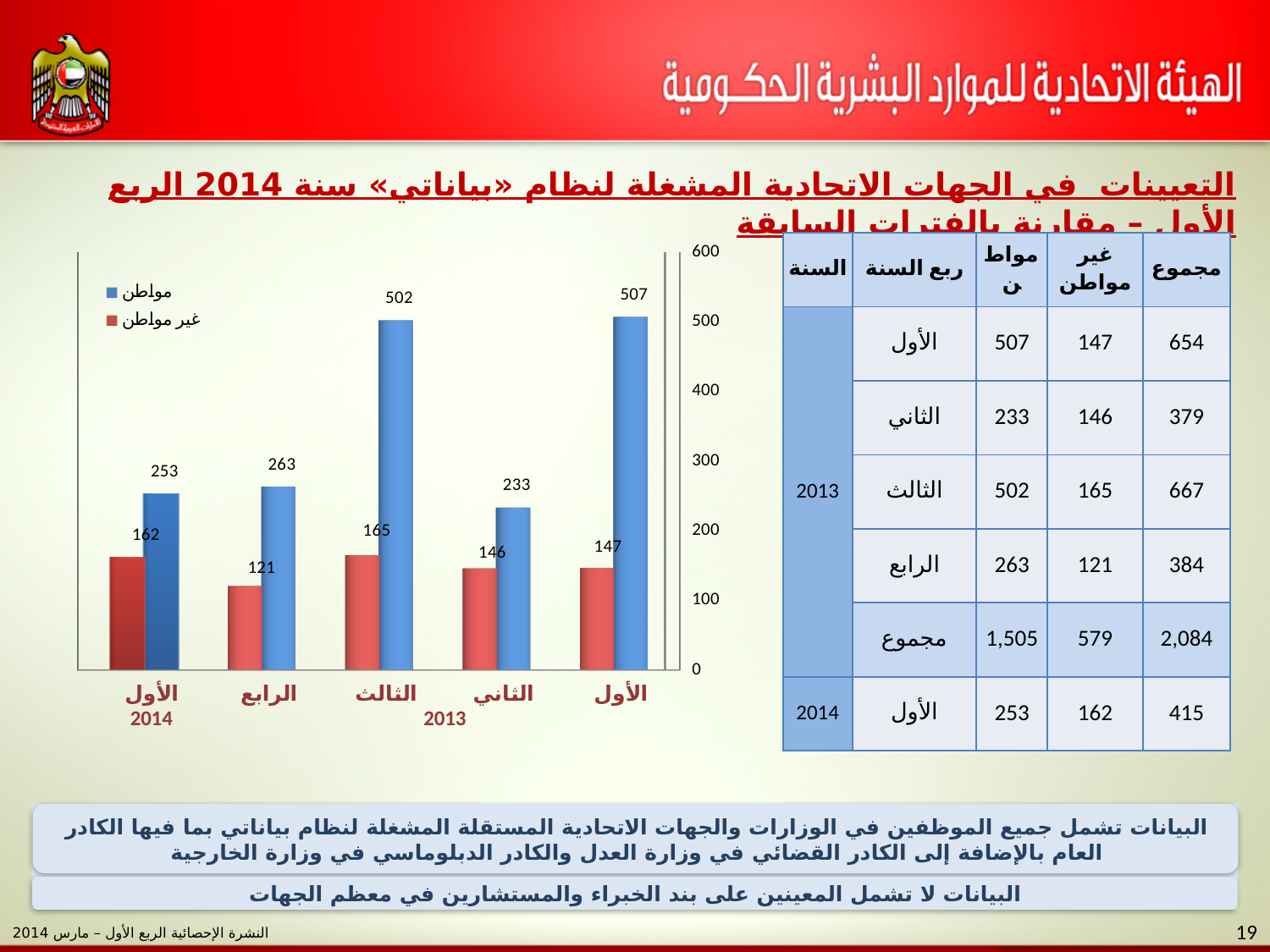
What is the difference between the مواطن values for الثالث 2013 and الثاني 2013? 269 What is the value of مواطن for الأول 2013 in the chart? 507 Which quarter has the lowest غير مواطن value in the chart? الرابع 2013 Is the مواطن value for الرابع 2013 greater or less than 300? less What is the value of غير مواطن for الرابع 2013 in the chart? 121 How many quarter categories are plotted on the chart's x axis? 5 What is the value of مواطن for الأول 2014 in the chart? 253 What type of chart is shown on the slide? bar chart Which is larger in the chart: the غير مواطن value for الأول 2014 or for الثالث 2013? الثالث 2013 What are the two series named in the chart legend? مواطن and غير مواطن How many series does the chart legend list? 2 Which quarter has the highest مواطن value in the chart? الأول 2013